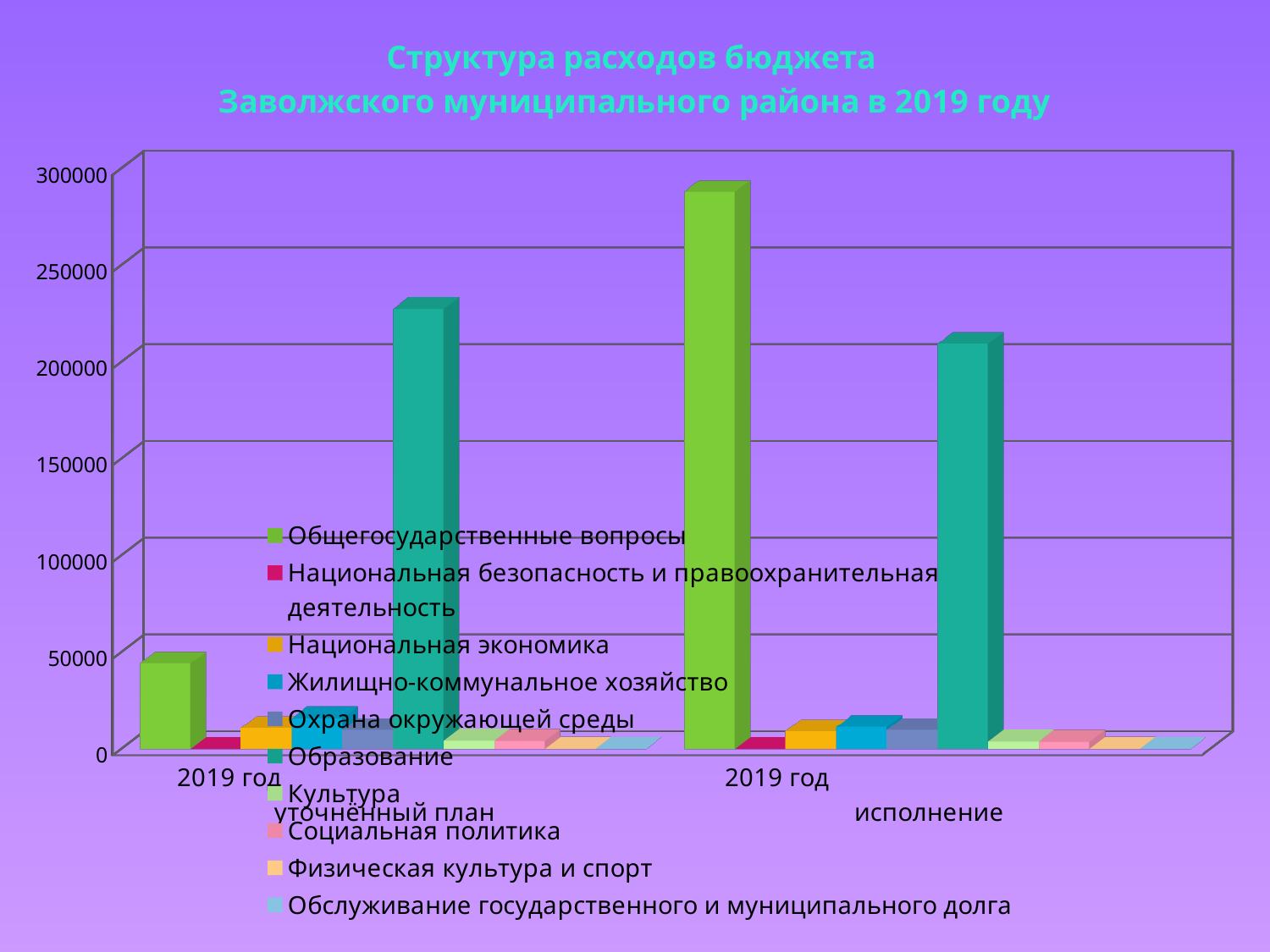
In the "2019 год исполнение" category, which is larger: Общегосударственные вопросы or Образование? Общегосударственные вопросы How many categories are shown on the x axis? 2 Is the value for Общегосударственные вопросы in "2019 год уточнённый план" greater or less than 50000? less Is the value for Образование in "2019 год уточнённый план" greater or less than 200000? greater How many series does the legend list? 10 Which series has the highest value in the "2019 год уточнённый план" category? Образование What is the title of the chart? Структура расходов бюджета Заволжского муниципального района в 2019 году What kind of chart is shown on the slide? bar chart Is the value for Общегосударственные вопросы in "2019 год исполнение" greater or less than 250000? greater Does the value for Общегосударственные вопросы rise or fall from "2019 год уточнённый план" to "2019 год исполнение"? rise Which series has the highest value in the "2019 год исполнение" category? Общегосударственные вопросы For Общегосударственные вопросы, which category has the larger value: "2019 год уточнённый план" or "2019 год исполнение"? 2019 год исполнение